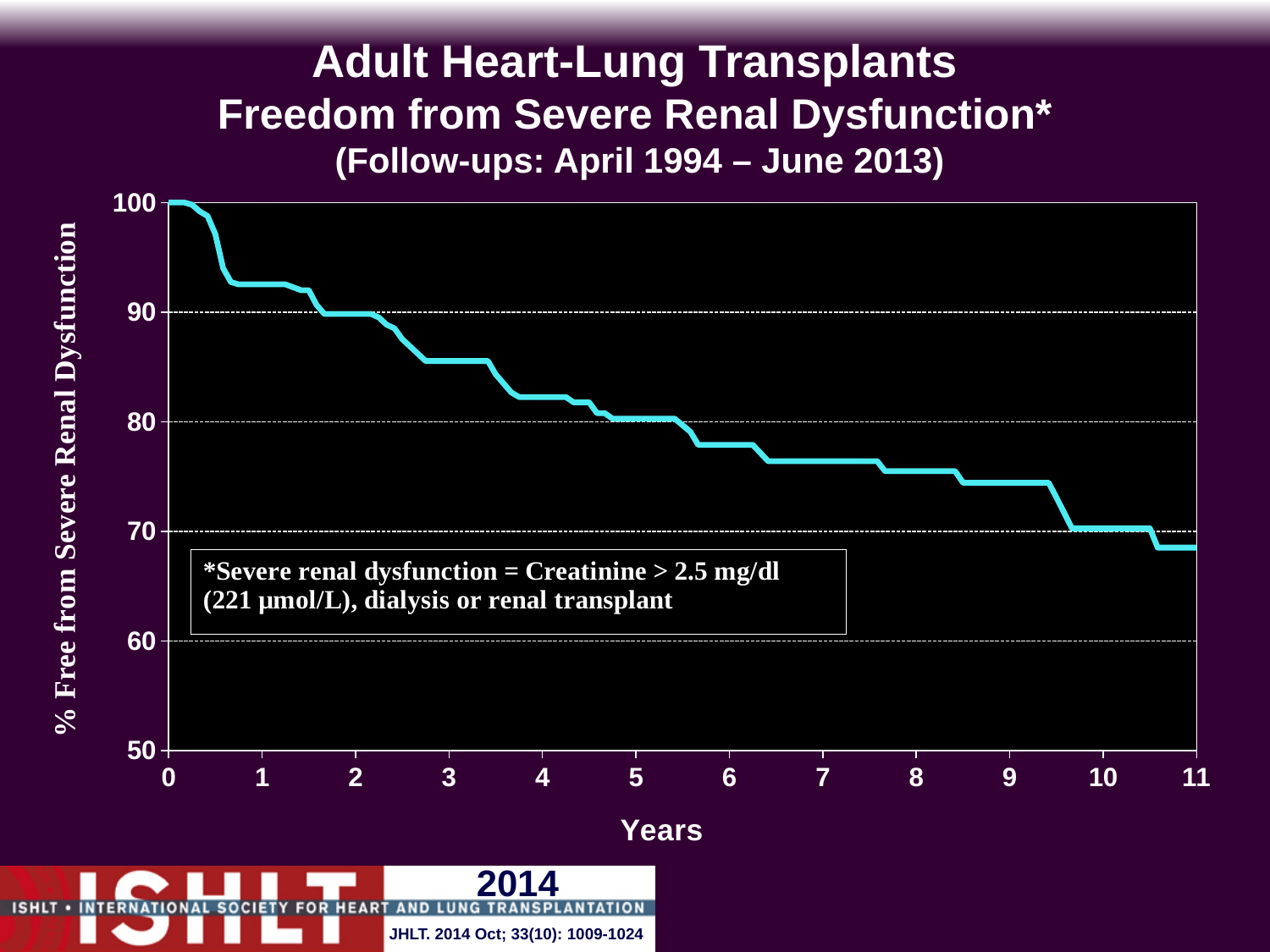
What is the label of the y axis? % Free from Severe Renal Dysfunction Is the value for year 9 greater or less than 70? greater What is the label of the x axis? Years Is the value for year 7 greater or less than 80? less Is the value for year 11 greater or less than 70? less What is the value of % free from severe renal dysfunction at year 0? 100 Which is larger, the value at year 2 or the value at year 8? year 2 Do the values rise or fall as the years increase along the x axis? fall What kind of chart is shown on the slide? line chart